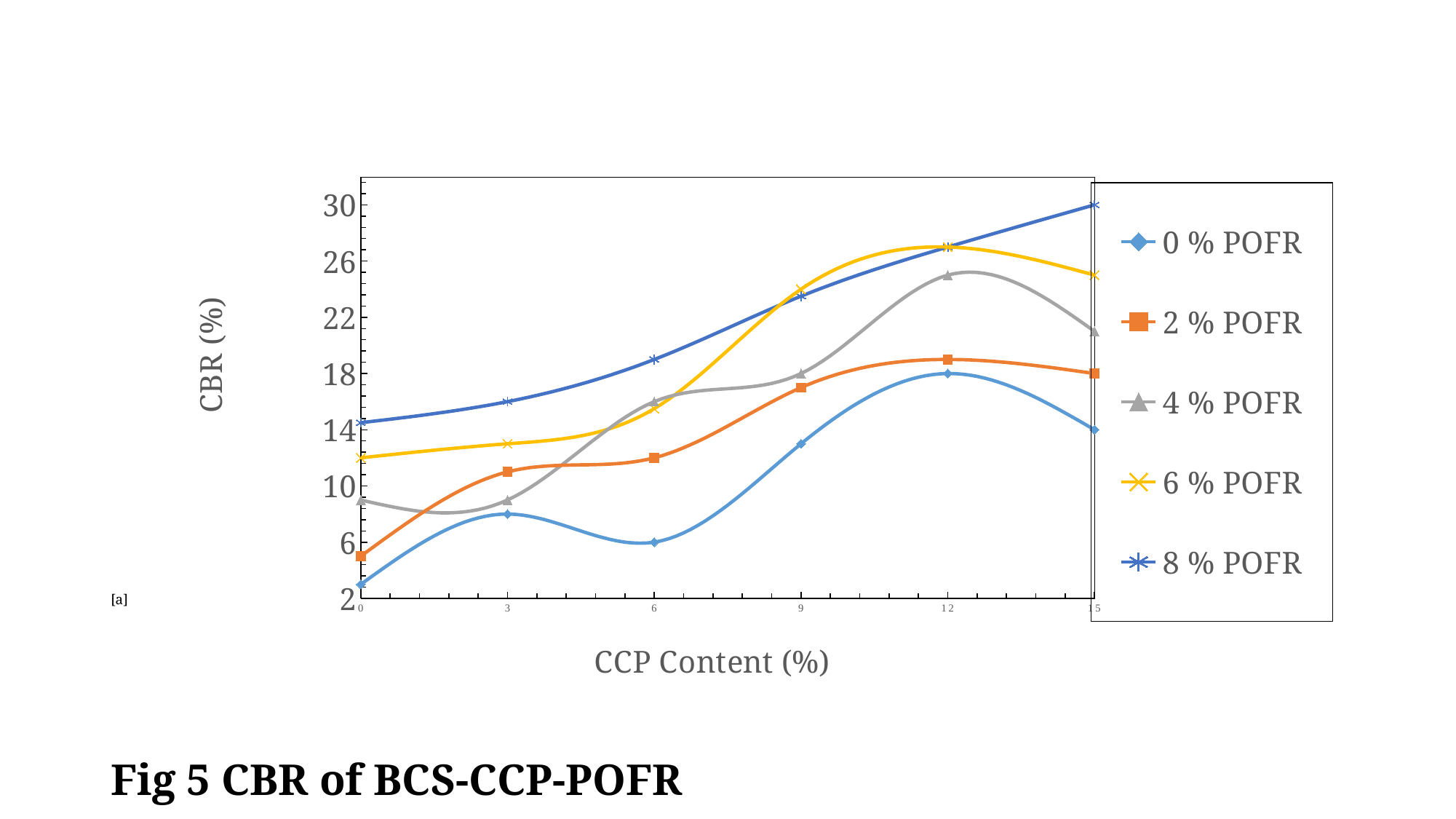
Which series has the lowest CBR at 15% CCP content? 0 % POFR At 3% CCP content, which has the larger CBR: 2 % POFR or 4 % POFR? 2 % POFR Does the CBR for 8 % POFR rise or fall as CCP content increases from 0 to 15? rise Is the CBR value for 6 % POFR at 12% CCP content greater or less than 26? greater What is the CBR value for 8 % POFR at 15% CCP content? 30 What is the CBR value for 0 % POFR at 12% CCP content? 18 What kind of chart is shown on the slide? line chart What is the CBR value for 0 % POFR at 6% CCP content? 6 Which series has the highest CBR at 15% CCP content? 8 % POFR How many series does the legend list? 5 How many CCP content values are plotted along the x axis? 6 Is the CBR value for 2 % POFR at 0% CCP content greater or less than 6? less